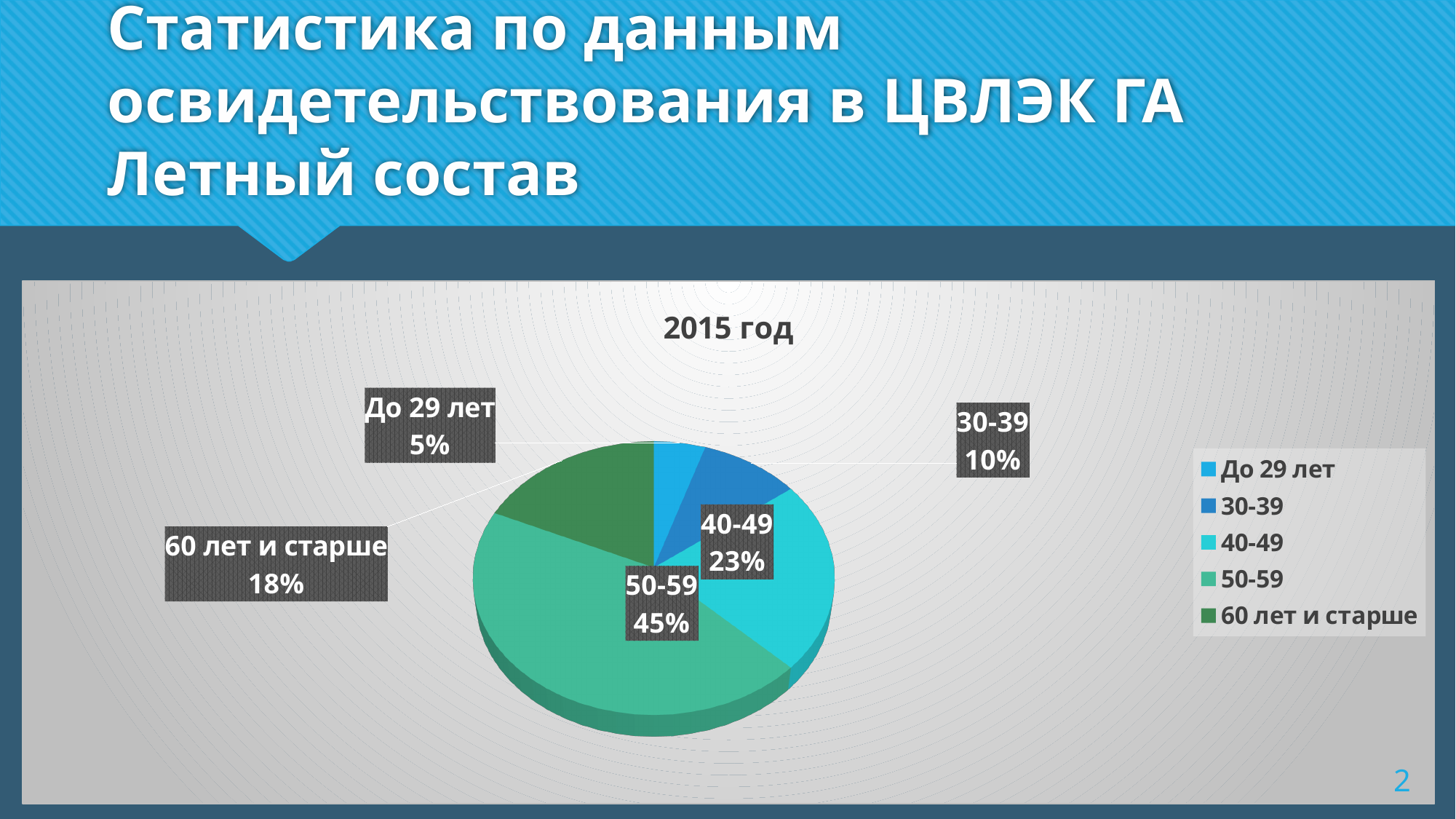
What is the difference in percentage points between the 50-59 and 40-49 groups? 22% How many age groups are shown in the pie chart? 5 What share of the pie does the 40-49 age group have? 23% Which age group has the largest share of the pie? 50-59 What share of the pie does the 30-39 age group have? 10% Which age group has the smallest share of the pie? До 29 лет What share of the pie does the 50-59 age group have? 45% What type of chart is shown on the slide? pie chart What is the title of the chart? 2015 год Which has a larger share, the 30-39 group or the '60 лет и старше' group? 60 лет и старше